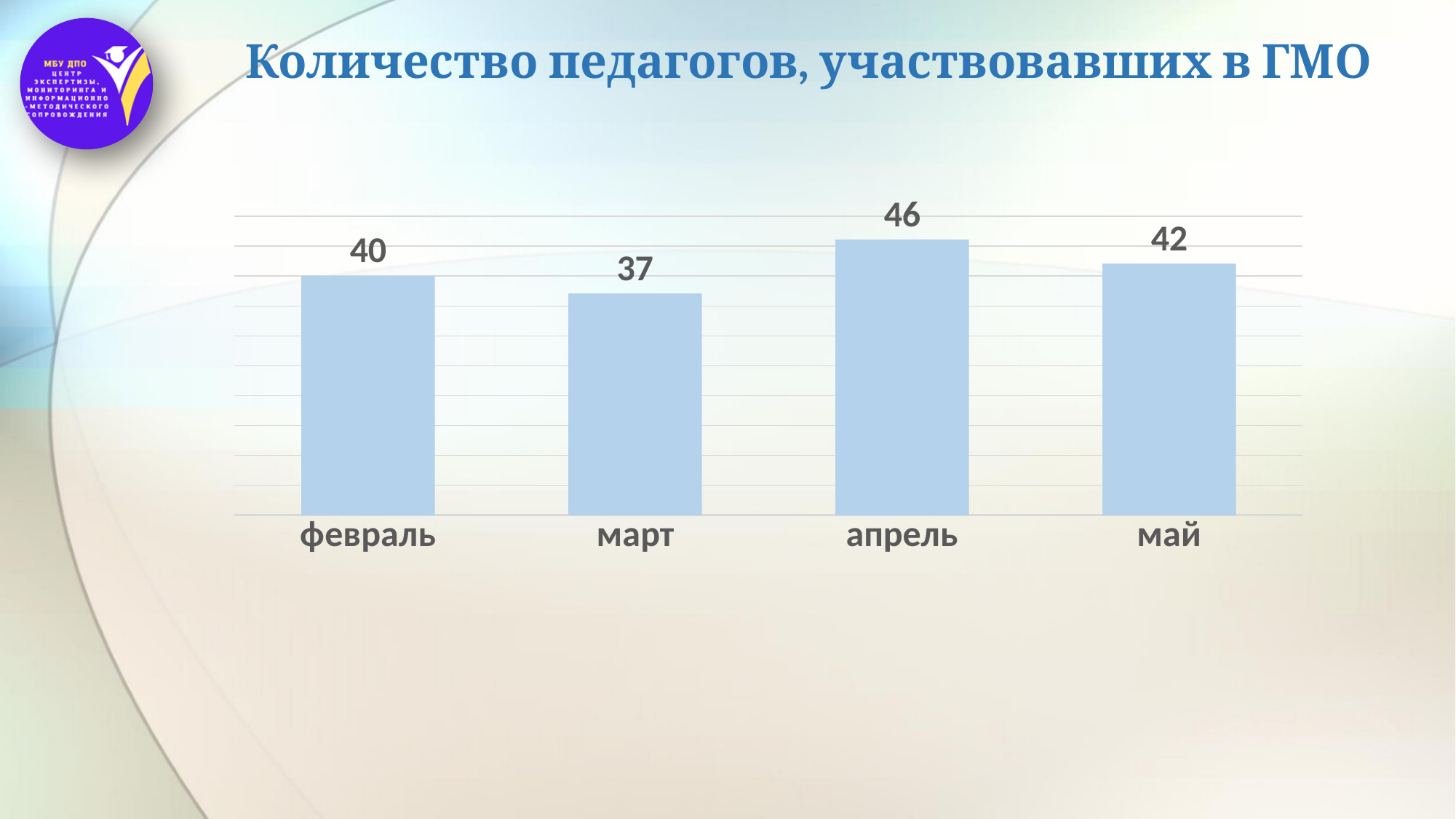
What kind of chart is shown on the slide? bar chart What is the value for май? 42 What is the value for апрель? 46 What is the difference between the values for май and февраль? 2 Which month has the highest value? апрель What is the value for март? 37 What is the value for февраль? 40 Which is larger, the value for февраль or the value for май? май What is the title of the slide? Количество педагогов, участвовавших в ГМО How many months are shown on the chart? 4 What is the difference between the values for апрель and март? 9 Which month has the lowest value? март